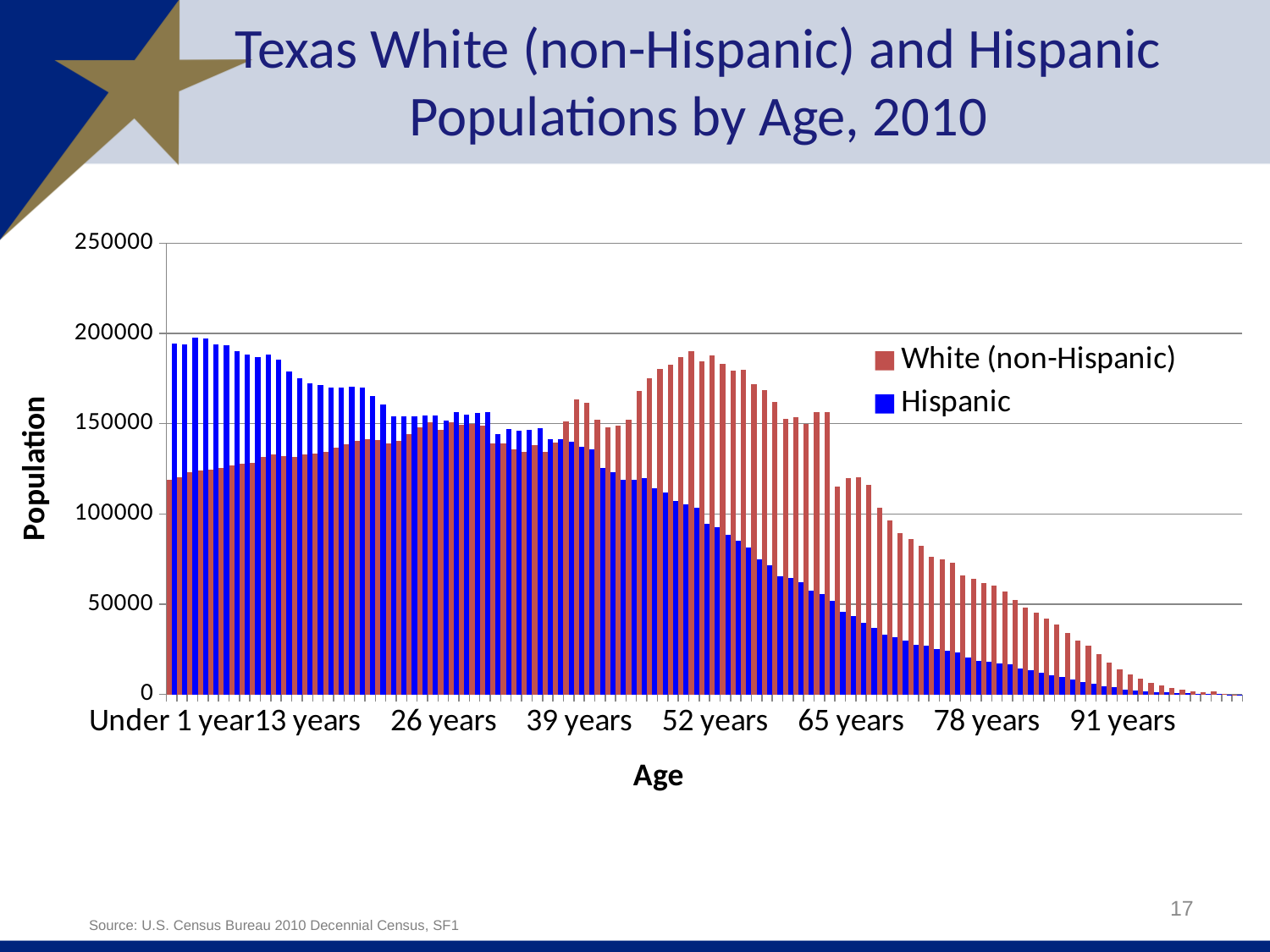
At 52 years, which series has the larger value, White (non-Hispanic) or Hispanic? White (non-Hispanic) How many series does the legend list? 2 Is the Hispanic value for 78 years greater or less than 50000? less Is the White (non-Hispanic) value for 91 years greater or less than 50000? less What kind of chart is shown on the slide? bar chart What is the title of the chart? Texas White (non-Hispanic) and Hispanic Populations by Age, 2010 Do the Hispanic values generally rise or fall from Under 1 year to 91 years? fall Is the Hispanic value for Under 1 year greater or less than 150000? greater At Under 1 year, which series has the larger value, White (non-Hispanic) or Hispanic? Hispanic What is the label of the vertical axis? Population